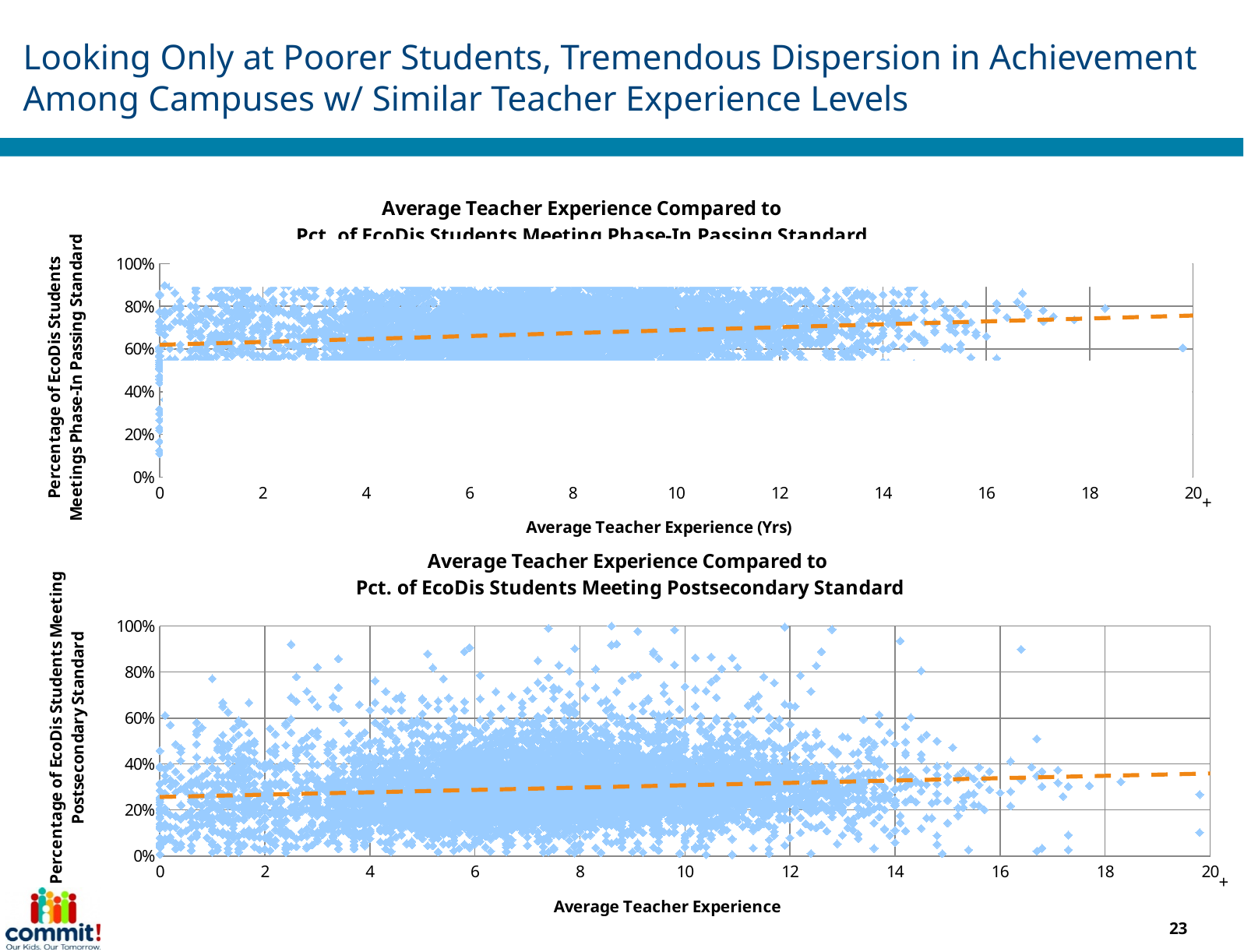
At 10 years of average teacher experience, which chart's trend line is higher: the top chart (Phase-In Passing Standard) or the bottom chart (Postsecondary Standard)? The top chart (Phase-In Passing Standard) In the bottom chart, is the trend line value at 20+ years of experience greater or less than 60%? less In the bottom chart, is the trend line value at 0 years of experience greater or less than 40%? less In the top chart, is the trend line value at 20+ years of experience greater or less than 60%? greater What kind of chart is the bottom chart, 'Average Teacher Experience Compared to Pct. of EcoDis Students Meeting Postsecondary Standard'? Scatter chart What kind of chart is the top chart, 'Average Teacher Experience Compared to Pct. of EcoDis Students Meeting Phase-In Passing Standard'? Scatter chart In the bottom chart, does the dashed trend line rise or fall as average teacher experience increases? Rises What is the x-axis title of the bottom chart? Average Teacher Experience What is the title of the bottom chart? Average Teacher Experience Compared to Pct. of EcoDis Students Meeting Postsecondary Standard In the top chart, does the dashed trend line rise or fall as average teacher experience increases? Rises